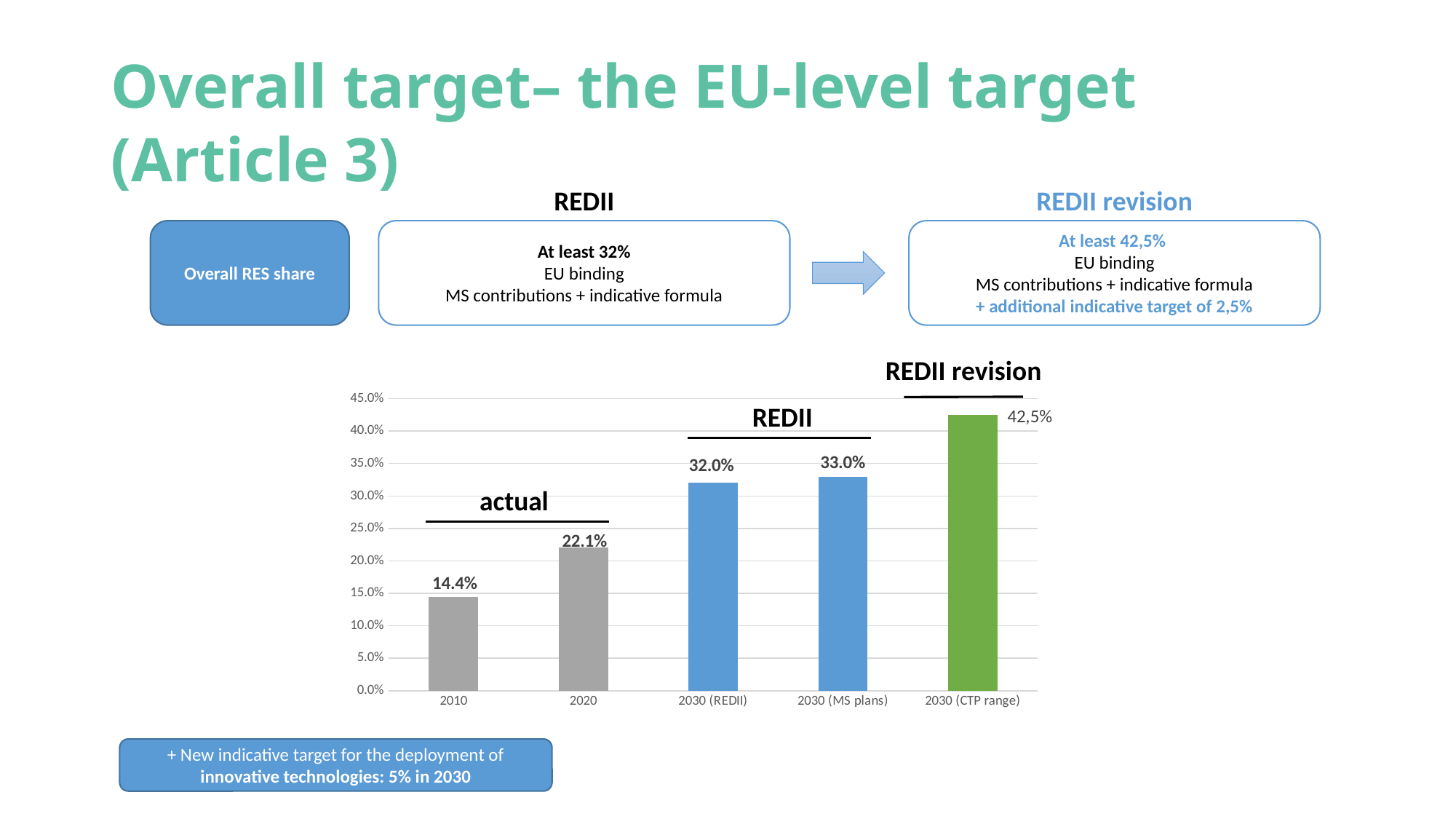
What is the value shown for 2030 (MS plans)? 33.0% How many bars are plotted in the chart? 5 What is the value shown for 2030 (CTP range)? 42,5% What is the value shown for 2010? 14.4% Which category has the highest value? 2030 (CTP range) What kind of chart is shown on the slide? Bar chart Which category has the lowest value? 2010 What is the value shown for 2020? 22.1% What is the difference between the 2030 (MS plans) value and the 2030 (REDII) value? 1.0% Which is larger, the value for 2020 or the value for 2030 (REDII)? 2030 (REDII) What is the difference between the 2020 value and the 2010 value? 7.7% What is the value shown for 2030 (REDII)? 32.0%